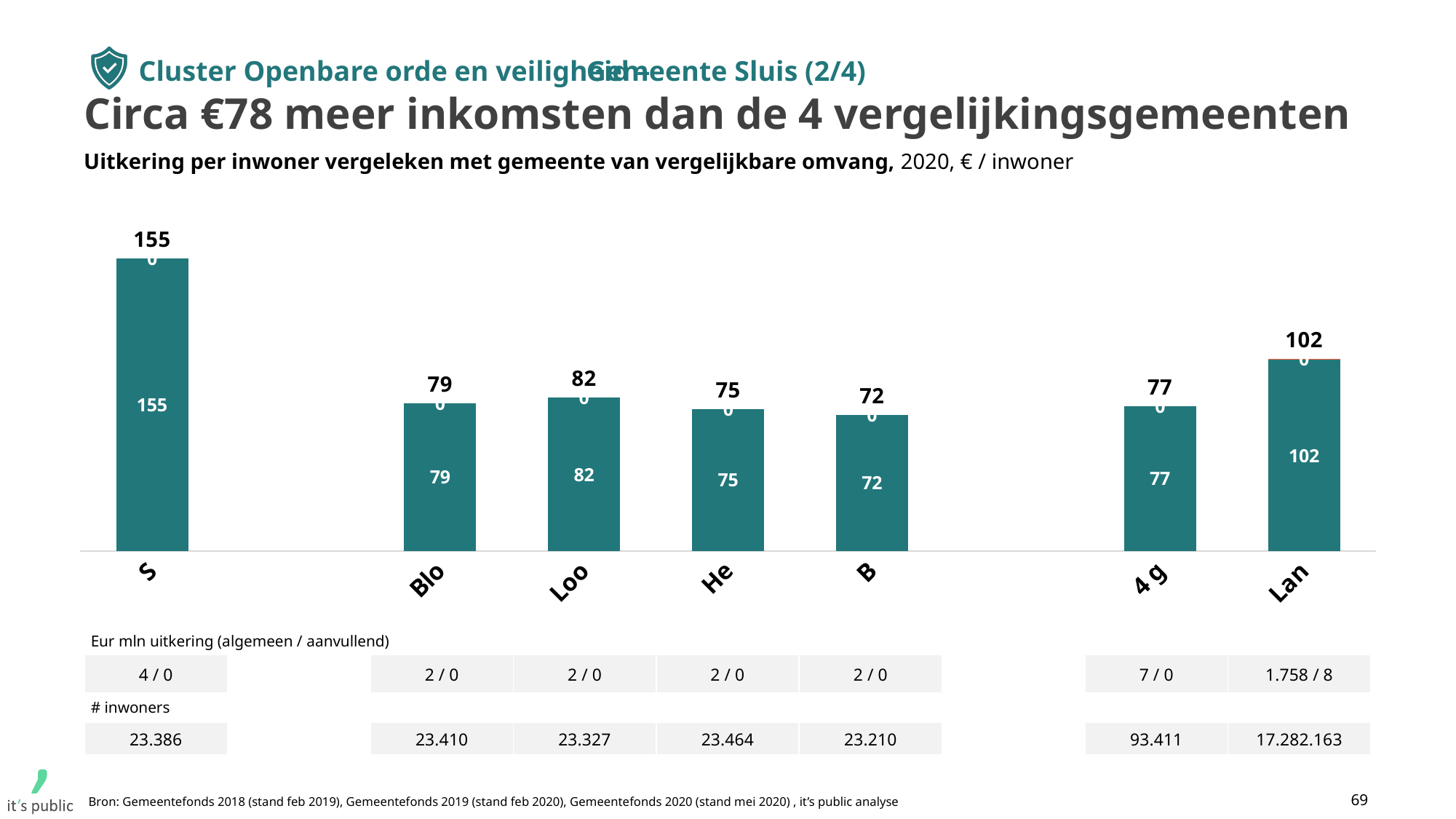
What kind of chart is shown on the slide? Bar chart Which is larger, the value for Blo or the value for B? Blo What is the value for 4 g? 77 What is the value for Lan? 102 What is the value for S? 155 How many bars are shown in the chart? 7 What unit is stated in the chart subtitle for the values? € / inwoner Which category has the lowest value? B What is the difference between the values for S and 4 g? 78 What is the difference between the values for Loo and He? 7 Which category has the highest value? S What is the value for Loo? 82